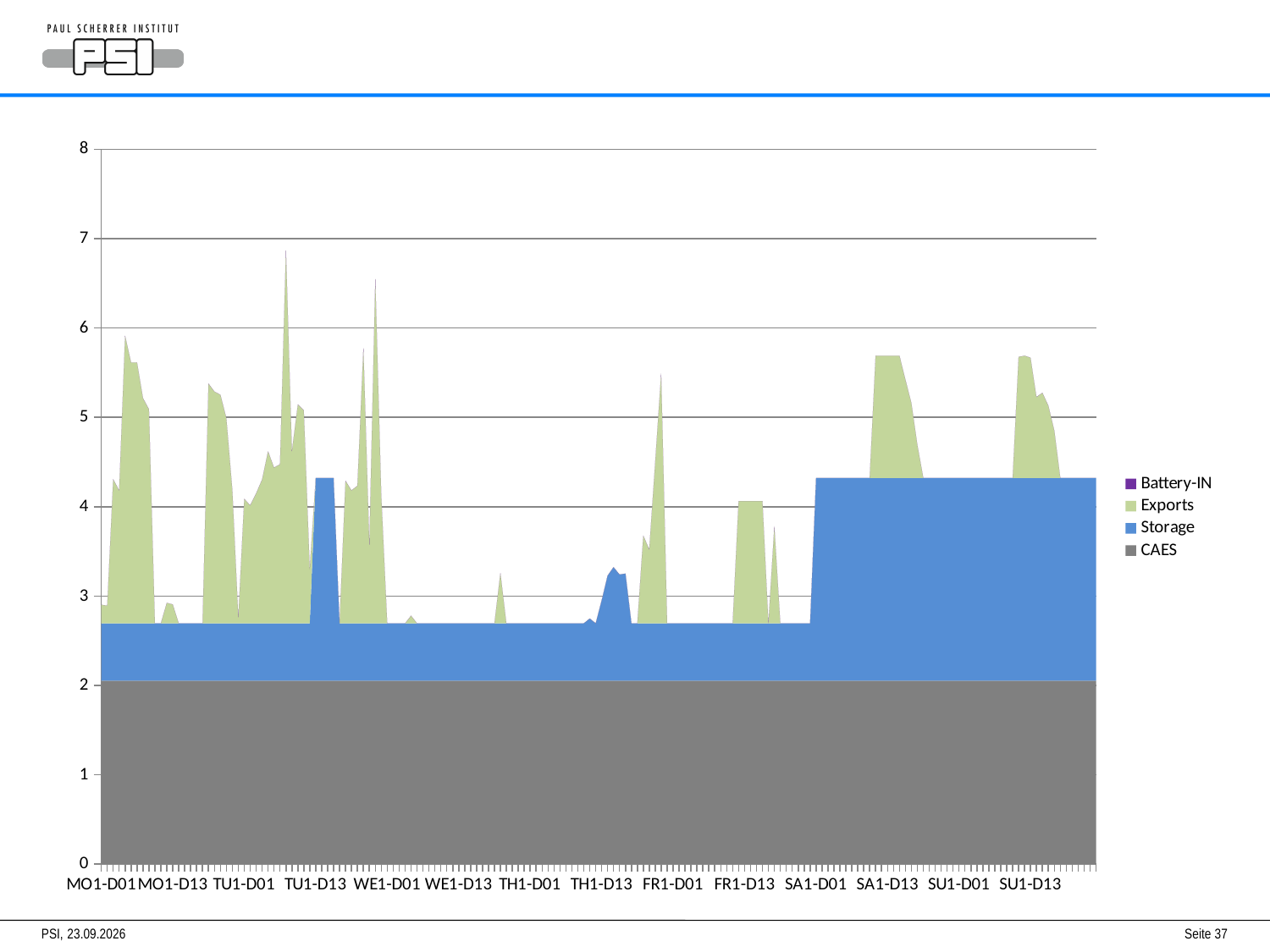
Is the stacked total at TH1-D01 greater or less than 3? less Is the stacked total at WE1-D13 greater or less than 3? less Which series is listed first in the legend? Battery-IN What kind of chart is shown on the slide? area chart Which series is shown in grey at the bottom of the stacked area? CAES How many category labels are shown along the x axis? 14 How many series does the legend list? 4 Is the highest peak of the stacked total greater or less than 6? greater Is the stacked total at SU1-D01 larger than the stacked total at WE1-D13? Yes What is the maximum value shown on the y axis? 8